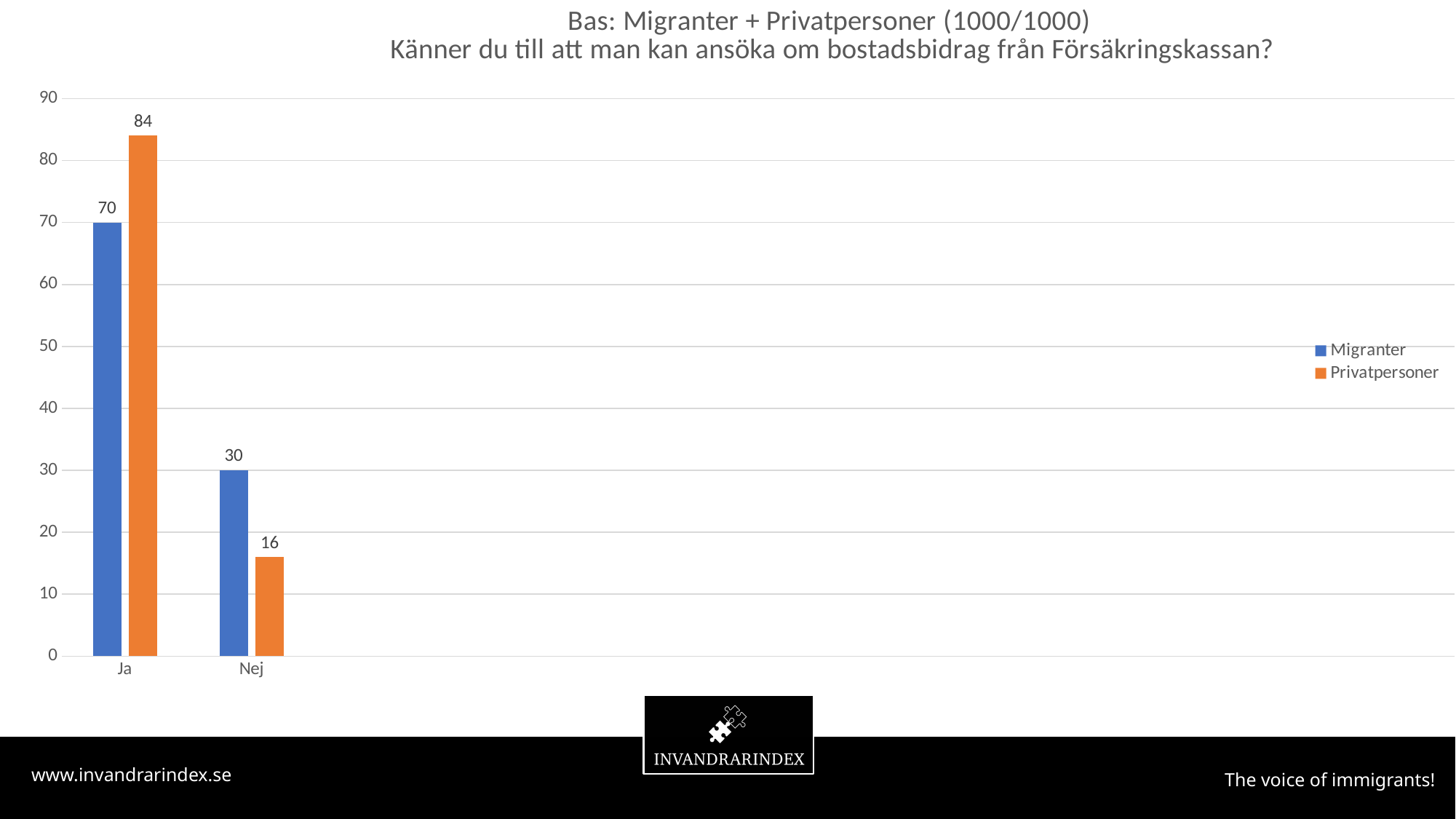
What kind of chart is shown on the slide? Bar chart What is the value for Migranter in the Nej category? 30 What is the value for Privatpersoner in the Nej category? 16 What is the difference between the Privatpersoner and Migranter values for Ja? 14 Which is larger: the Migranter value for Ja or the Migranter value for Nej? Ja What is the value for Privatpersoner in the Ja category? 84 What is the value for Migranter in the Ja category? 70 What is the difference between the Migranter and Privatpersoner values for Nej? 14 Which series has the lowest value in the Nej category? Privatpersoner How many categories are shown on the x axis? 2 Which series has the highest value in the Ja category? Privatpersoner How many series does the legend list? 2